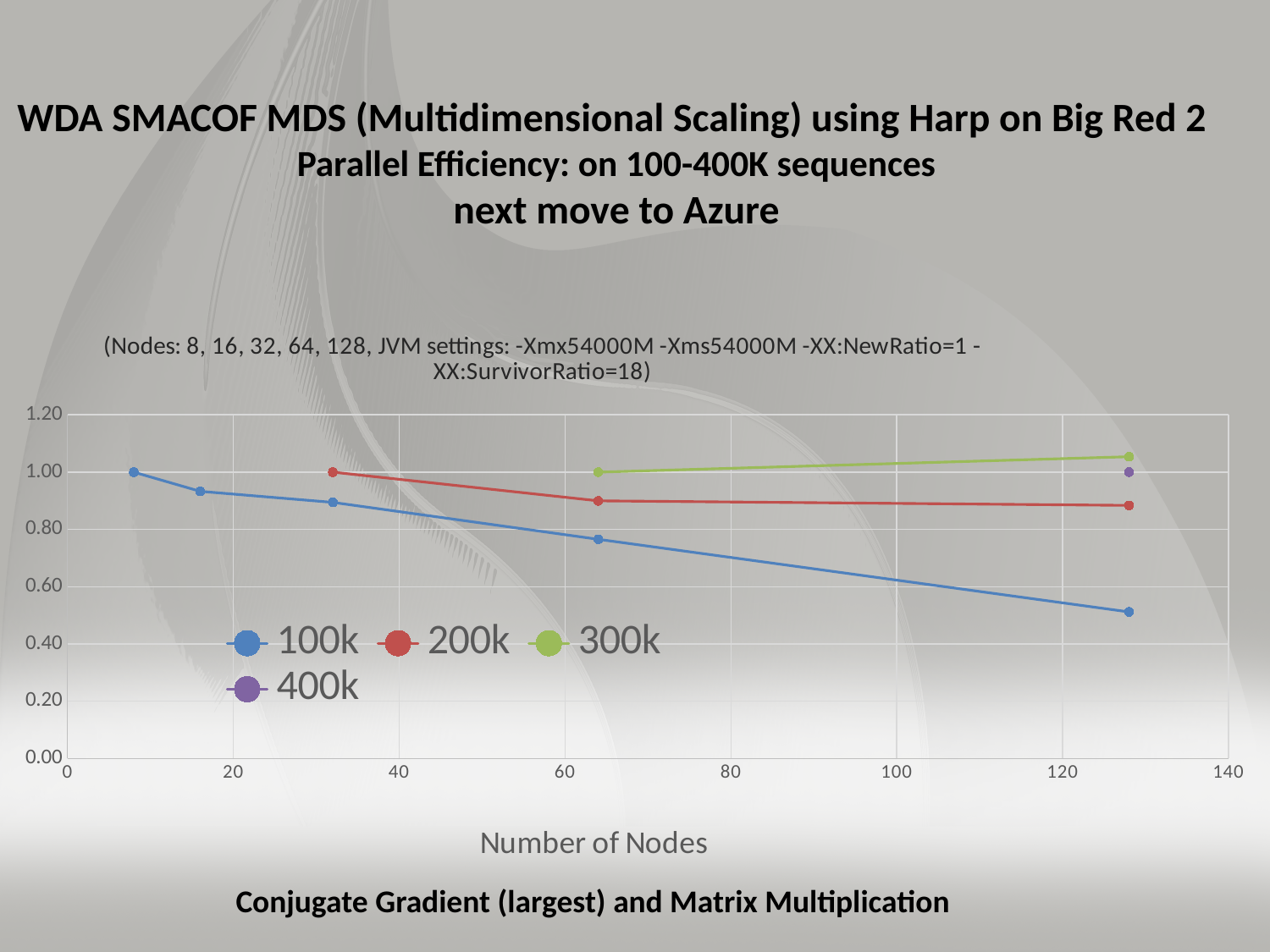
Is the value of the 300k series at its rightmost point (about 128 nodes) greater or less than 1.00? greater How many data points are plotted for the 400k series? 1 What is the value of the first (leftmost) point of the 100k series? 1.00 Which series is shown in blue in the legend? 100k How many series does the chart legend list? 4 Does the 100k series rise or fall as the number of nodes increases? fall What is the title of the x axis? Number of Nodes Is the value of the 200k series at its rightmost point (about 128 nodes) greater or less than 0.80? greater How many data points are plotted for the 100k series? 5 At the rightmost points (about 128 nodes), which series has the higher value, 100k or 300k? 300k What kind of chart is shown on the slide? line chart Is the value of the 100k series at its rightmost point (about 128 nodes) greater or less than 0.60? less